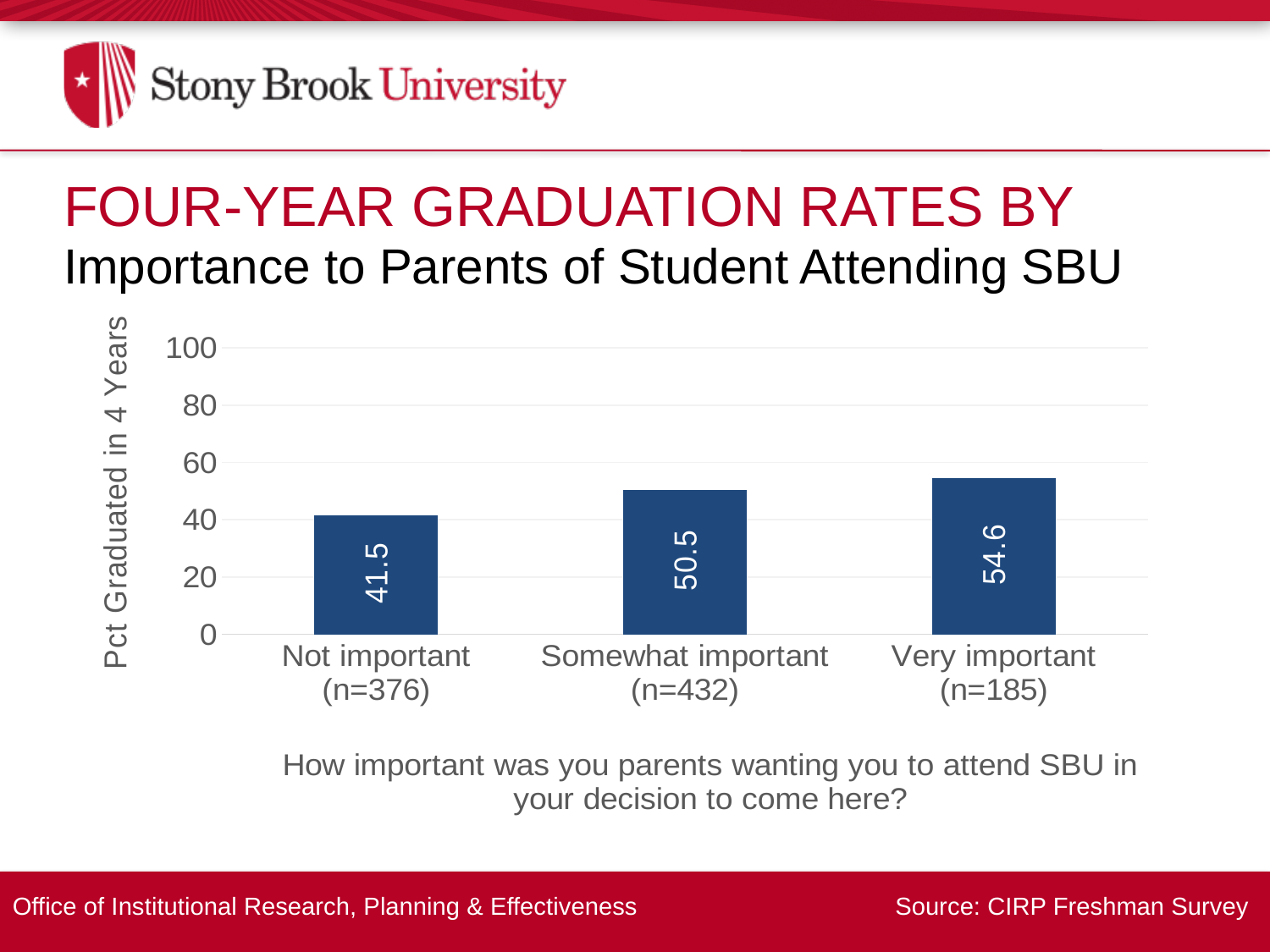
Which has a higher graduation rate: 'Somewhat important' or 'Very important'? Very important What kind of chart is shown on the slide? Bar chart What is the four-year graduation rate for the 'Somewhat important' category? 50.5 Which category has the highest four-year graduation rate? Very important What is the four-year graduation rate for the 'Very important' category? 54.6 What is the difference in graduation rate between the 'Very important' and 'Not important' categories? 13.1 Do the graduation rates rise or fall moving from 'Not important' to 'Very important'? Rise Which category has the lowest four-year graduation rate? Not important What is the four-year graduation rate for students who said their parents' wishes were 'Not important'? 41.5 How many categories are shown on the x axis? 3 Is the graduation rate for 'Not important' greater or less than 60? less What is the difference in graduation rate between the 'Somewhat important' and 'Not important' categories? 9.0